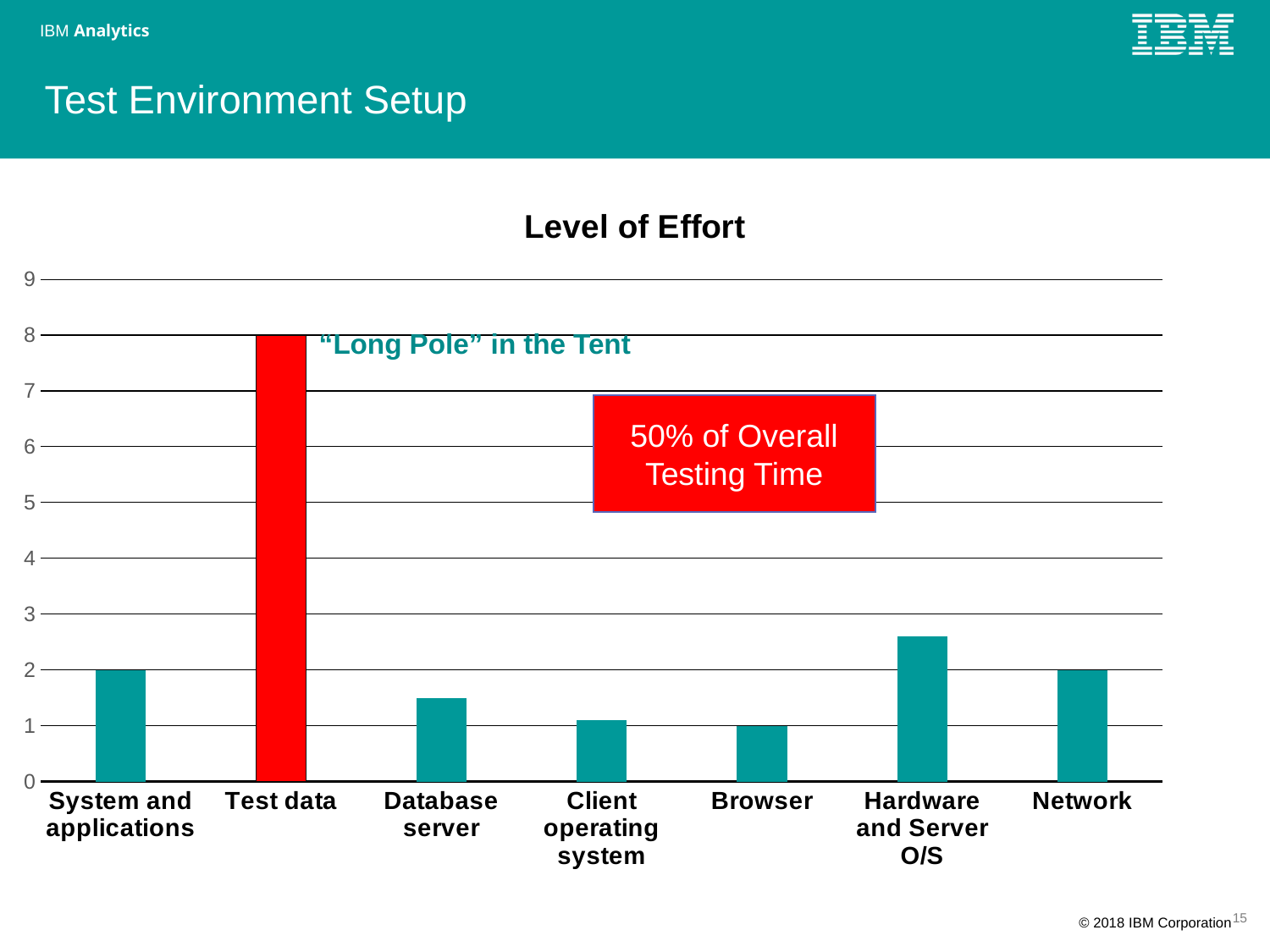
What kind of chart is shown on the slide? bar chart What is the value for Network? 2 What is the difference between the values for Test data and Browser? 7 What is the value for System and applications? 2 What is the value for Test data? 8 Is the value for Hardware and Server O/S greater or less than 2? greater What is the title of the chart? Level of Effort Is the value for Database server greater or less than 2? less What is the value for Browser? 1 Which bar is coloured red rather than teal? Test data How many categories are shown on the x axis of the chart? 7 Which category has the highest level of effort? Test data